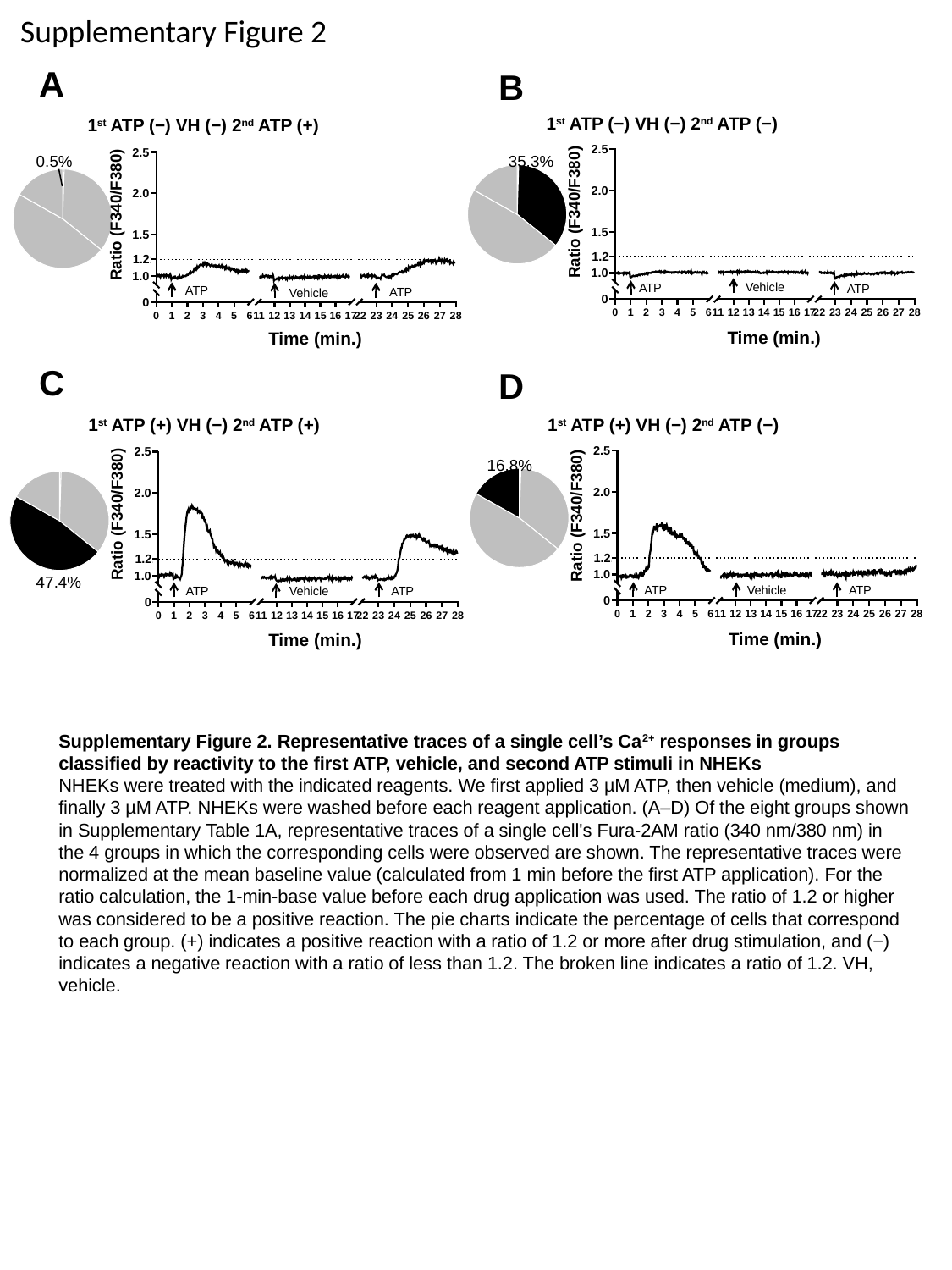
What kind of chart is the trace plot in panel A (the plot of Ratio versus Time)? Line chart Which panel's pie chart shows the smallest labeled percentage? A (0.5%) In panel C, is the peak ratio after the first ATP application greater or less than 1.5? greater In panel B, what percentage is labeled on the pie chart? 35.3% Which is larger: the percentage labeled in panel B's pie chart or the percentage labeled in panel D's pie chart? Panel B (35.3%) What is the difference between the percentage labeled in panel C's pie chart and the percentage labeled in panel B's pie chart? 12.1 percentage points In panel D, what percentage is labeled on the pie chart? 16.8% In panel B, is the ratio after the second ATP application greater or less than 1.2? less In panel C, what percentage is labeled on the pie chart? 47.4% Which panel's pie chart shows the largest labeled percentage? C (47.4%) What is the y-axis label of the trace plots in panels A–D? Ratio (F340/F380)